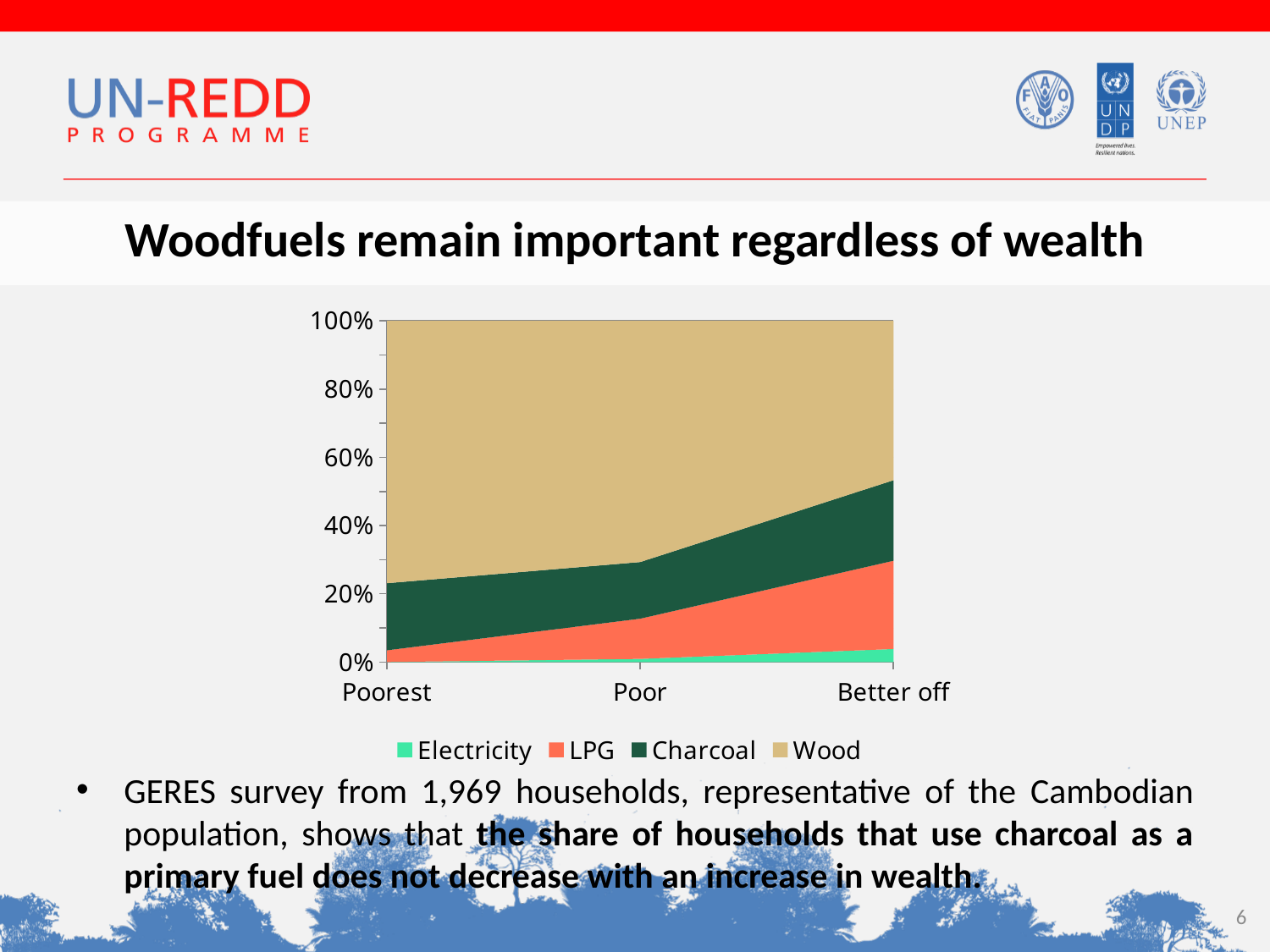
Is the share of Wood for Poorest greater or less than 60%? greater How many wealth categories are shown on the x axis of the chart? 3 Which category is shown at the far right of the x axis? Better off Which fuel has the smallest share for the Poorest category? Electricity How many series does the chart's legend list? 4 Is the combined share of Electricity, LPG and Charcoal for Better off greater or less than 40%? greater Does the combined share of Electricity, LPG and Charcoal rise or fall from Poorest to Better off? Rise Is the combined share of Electricity, LPG and Charcoal for Poorest greater or less than 40%? less What kind of chart is shown on the slide? Stacked area chart Which category has the largest share of Wood? Poorest Which fuels are listed in the chart's legend? Electricity, LPG, Charcoal, Wood Does the share of Wood rise or fall from Poorest to Better off? Fall